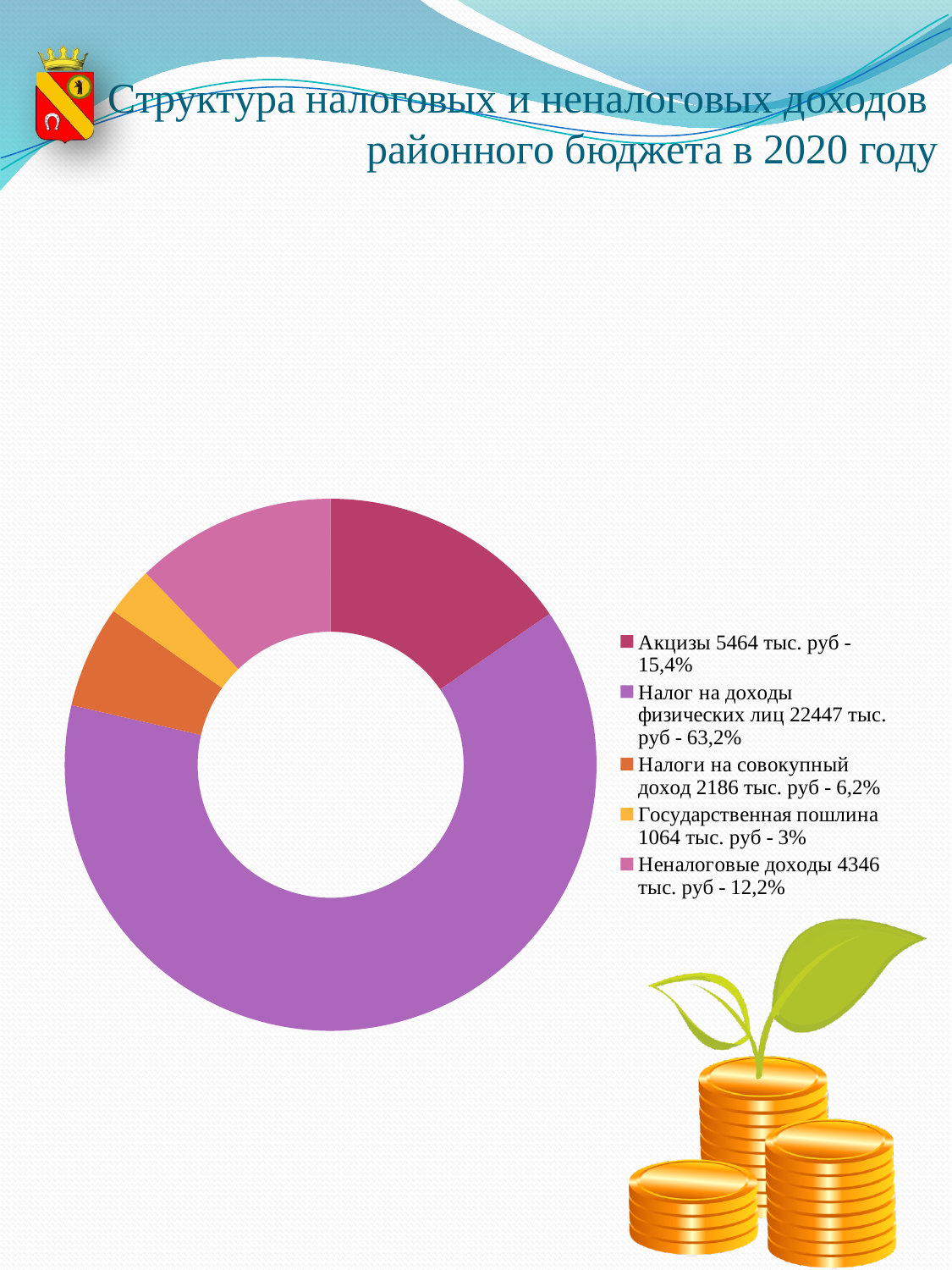
How many categories does the chart show? 5 Which category has the largest share of the chart? Налог на доходы физических лиц What share of the total does Налог на доходы физических лиц make up? 63,2% What kind of chart is shown on the slide? Pie chart (doughnut) What percentage is shown for Государственная пошлина? 3% What is the difference between the values for Акцизы and Неналоговые доходы? 1118 тыс. руб Which category has the smallest share of the chart? Государственная пошлина What is the value for Акцизы according to the legend? 5464 тыс. руб Which is larger, Акцизы or Неналоговые доходы? Акцизы What colour is the slice for Государственная пошлина? Yellow What is the value for Налоги на совокупный доход? 2186 тыс. руб What is the value for Неналоговые доходы? 4346 тыс. руб